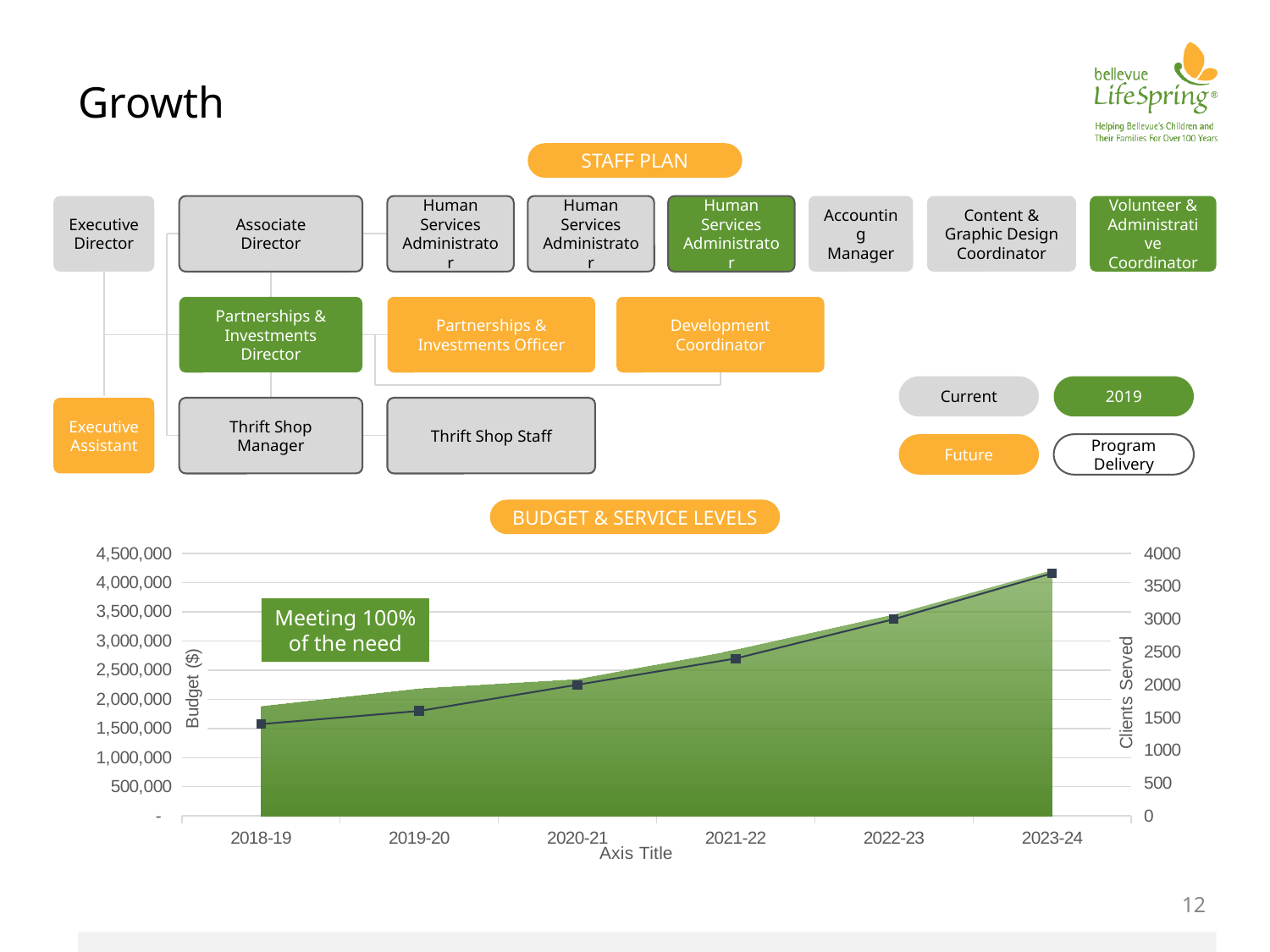
Is the budget for 2023-24 greater or less than 3,500,000? greater Is the number of clients served in 2023-24 greater or less than 3500? greater Which year has the larger budget, 2019-20 or 2022-23? 2022-23 Is the number of clients served in 2018-19 greater or less than 2000? less What is the title of the right-hand vertical axis of the Budget & Service Levels chart? Clients Served Which fiscal year has the highest budget in the Budget & Service Levels chart? 2023-24 What kind of chart is the Budget & Service Levels chart? area chart with a line How many fiscal-year categories are shown on the x axis of the Budget & Service Levels chart? 6 What text appears in the callout box inside the Budget & Service Levels chart? Meeting 100% of the need Do the budget values in the Budget & Service Levels chart rise or fall from 2018-19 to 2023-24? rise Which fiscal year has the lowest number of clients served in the Budget & Service Levels chart? 2018-19